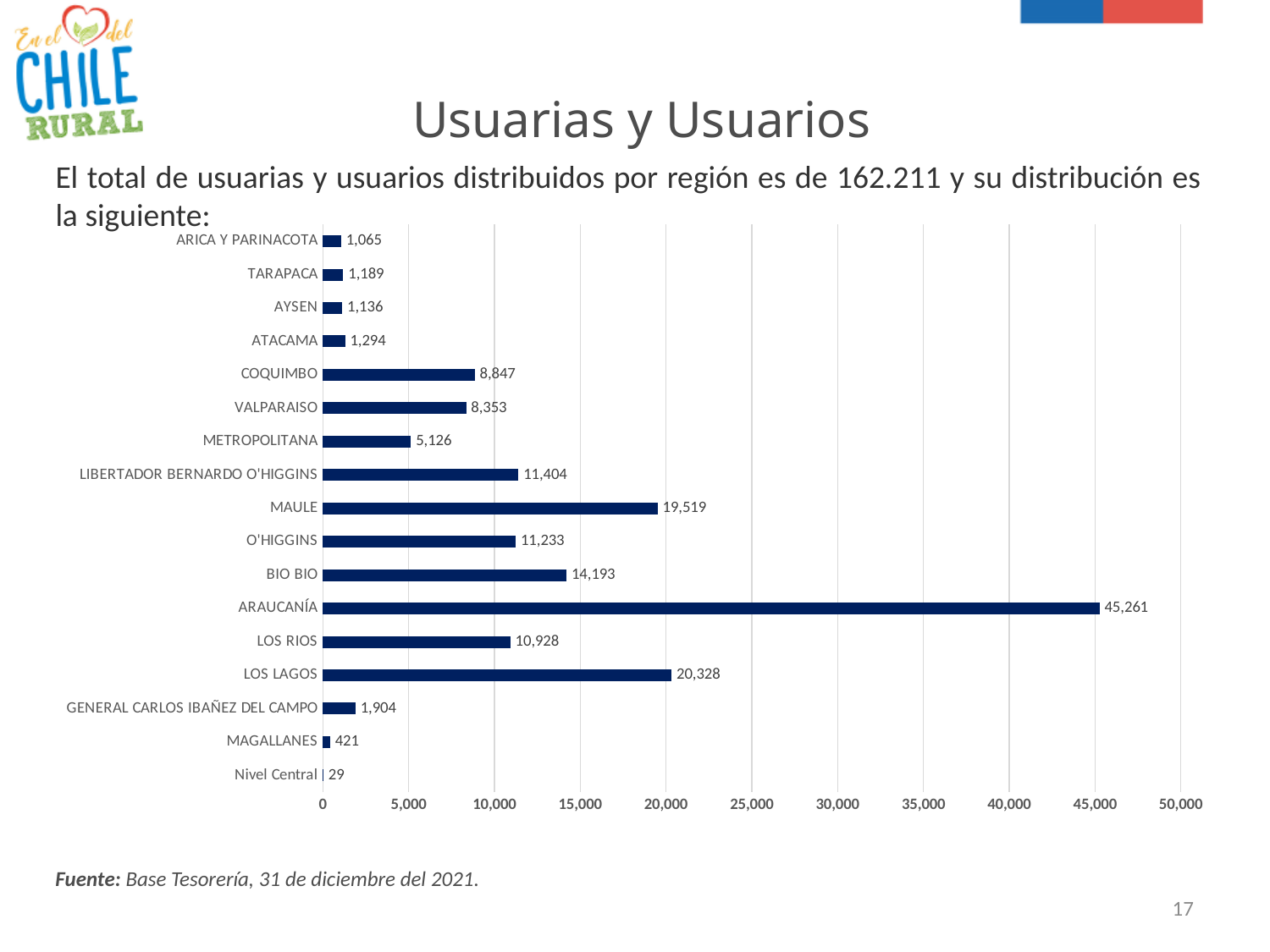
What is the value for METROPOLITANA? 5,126 Which region has the highest value? ARAUCANÍA What is the value for MAGALLANES? 421 What is the value for ARAUCANÍA? 45,261 Which is larger, the value for COQUIMBO or the value for VALPARAISO? COQUIMBO What kind of chart is shown on the slide? bar chart What is the value for LOS LAGOS? 20,328 How many categories are shown in the chart? 17 What is the maximum value shown on the horizontal axis? 50,000 Which category has the lowest value? Nivel Central What is the difference between the values for MAULE and BIO BIO? 5,326 Is the value for LOS RIOS greater or less than 10,000? greater